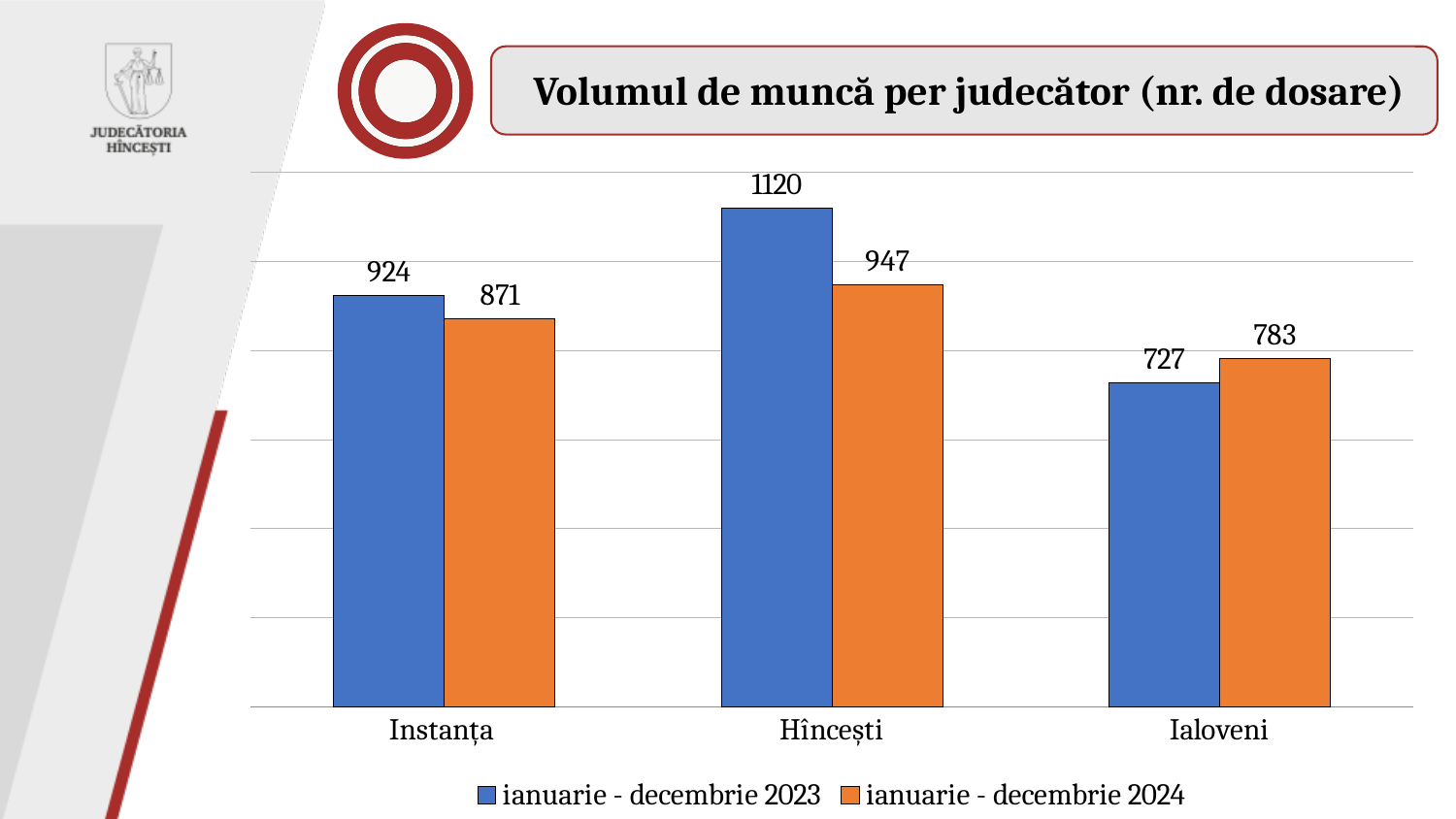
How many series does the legend list? 2 How many categories are shown on the x axis? 3 What is the difference between the 2023 and 2024 values for Hîncești? 173 What is the value for Hîncești in the ianuarie - decembrie 2023 series? 1120 What is the difference between the 2024 and 2023 values for Ialoveni? 56 Which category has the lowest value in the ianuarie - decembrie 2024 series? Ialoveni What is the value for Instanța in the ianuarie - decembrie 2024 series? 871 For Instanța, which series has the larger value: ianuarie - decembrie 2023 or ianuarie - decembrie 2024? ianuarie - decembrie 2023 What kind of chart is shown on the slide? bar chart What is the value for Ialoveni in the ianuarie - decembrie 2024 series? 783 What is the title of the chart? Volumul de muncă per judecător (nr. de dosare) Which category has the highest value in the ianuarie - decembrie 2023 series? Hîncești